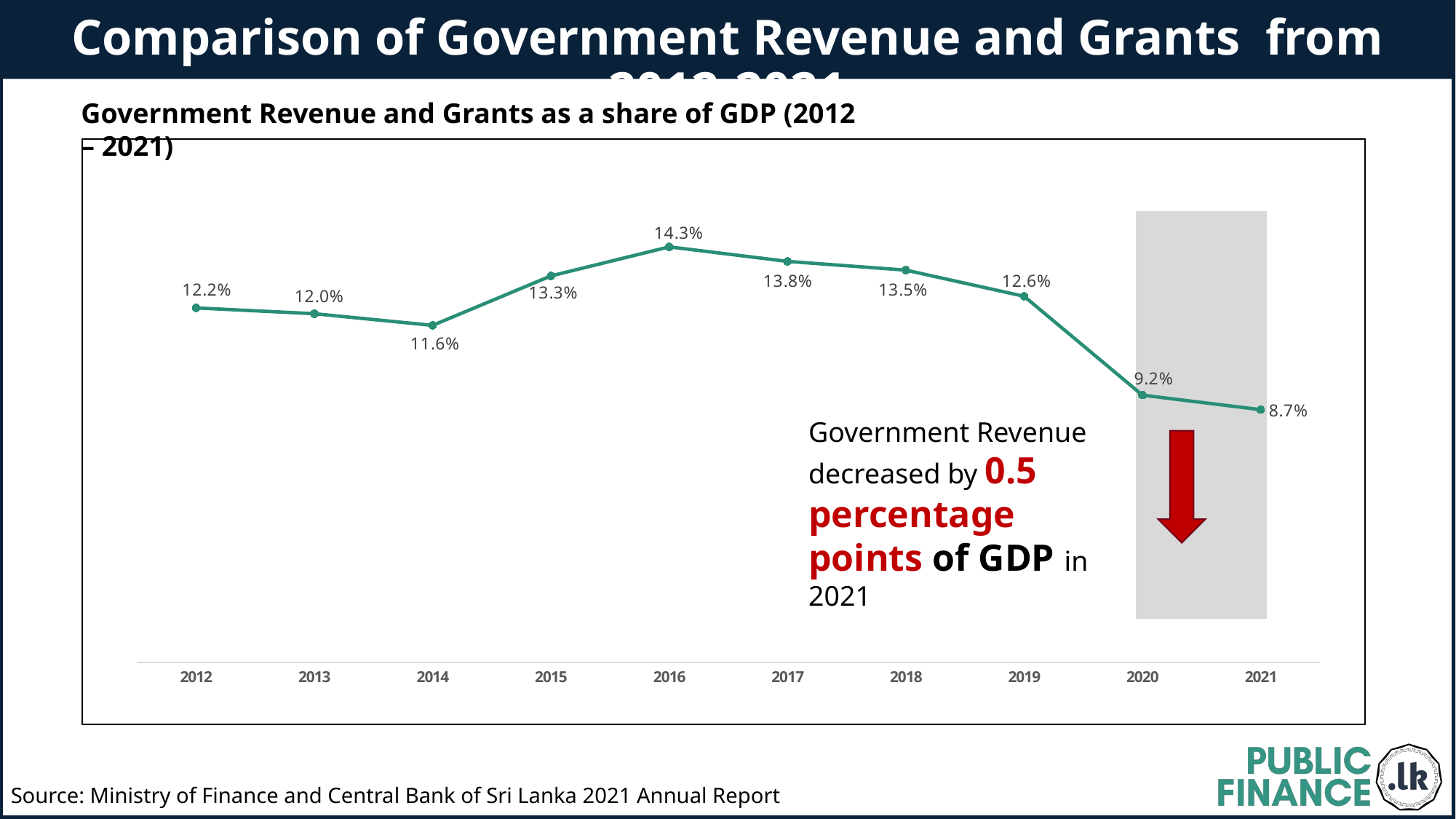
What type of chart is shown on the slide? Line chart What was Government Revenue and Grants as a share of GDP in 2016? 14.3% What is the source cited for the chart data? Ministry of Finance and Central Bank of Sri Lanka 2021 Annual Report What was Government Revenue and Grants as a share of GDP in 2014? 11.6% Which year has the lowest Government Revenue and Grants as a share of GDP? 2021 What was Government Revenue and Grants as a share of GDP in 2021? 8.7% Which year had a higher share of GDP, 2012 or 2019? 2019 Which year has the highest Government Revenue and Grants as a share of GDP? 2016 What is the difference between the 2016 value and the 2021 value? 5.6 percentage points Did Government Revenue and Grants as a share of GDP rise or fall between 2016 and 2021? Fall By how many percentage points did Government Revenue and Grants as a share of GDP fall from 2020 to 2021? 0.5 percentage points How many years are plotted on the chart? 10